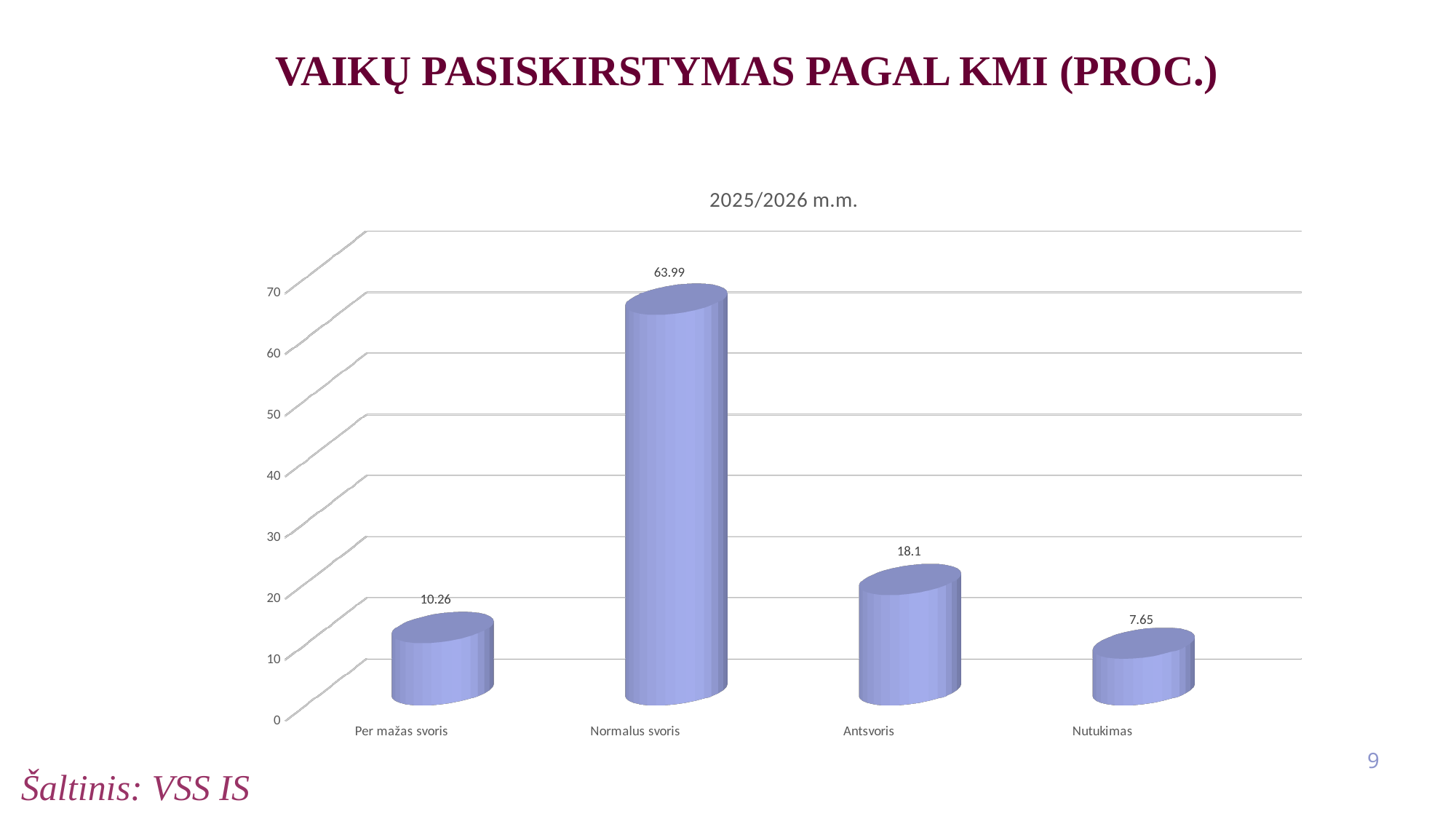
Which category has the highest value? Normalus svoris What is the value for Per mažas svoris? 10.26 What is the value for Antsvoris? 18.1 What is the difference between the values for Antsvoris and Per mažas svoris? 7.84 What is the value for Normalus svoris? 63.99 What kind of chart is shown on the slide? bar chart What is the value for Nutukimas? 7.65 What is the title of the chart? 2025/2026 m.m. Which is larger, the value for Per mažas svoris or the value for Nutukimas? Per mažas svoris Is the value for Normalus svoris greater or less than 60? greater Which category has the lowest value? Nutukimas How many categories are shown on the x axis? 4